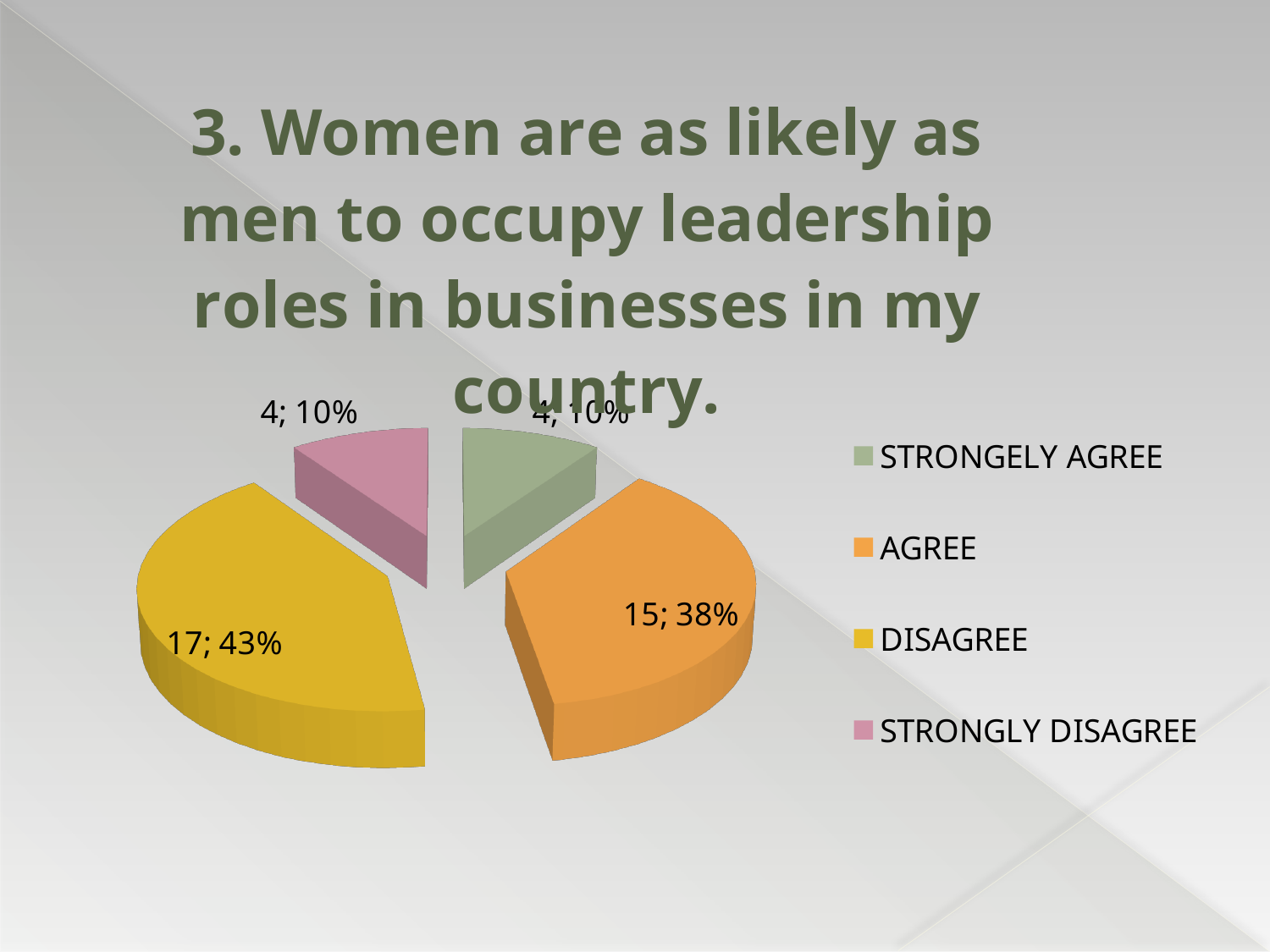
What is the total number of responses across all slices? 40 What percentage of responses is STRONGLY DISAGREE? 10% Which is larger, the AGREE slice or the DISAGREE slice? DISAGREE What is the difference in count between DISAGREE and AGREE? 2 Which colour represents STRONGLY DISAGREE in the pie chart? Pink How many entries does the legend list? 4 What is the count and percentage shown for AGREE? 15; 38% What kind of chart is shown on the slide? Pie chart What is the count and percentage shown for DISAGREE? 17; 43% What percentage of responses is STRONGLY AGREE? 10% Which response category has the largest slice? DISAGREE How many slices does the pie chart have? 4